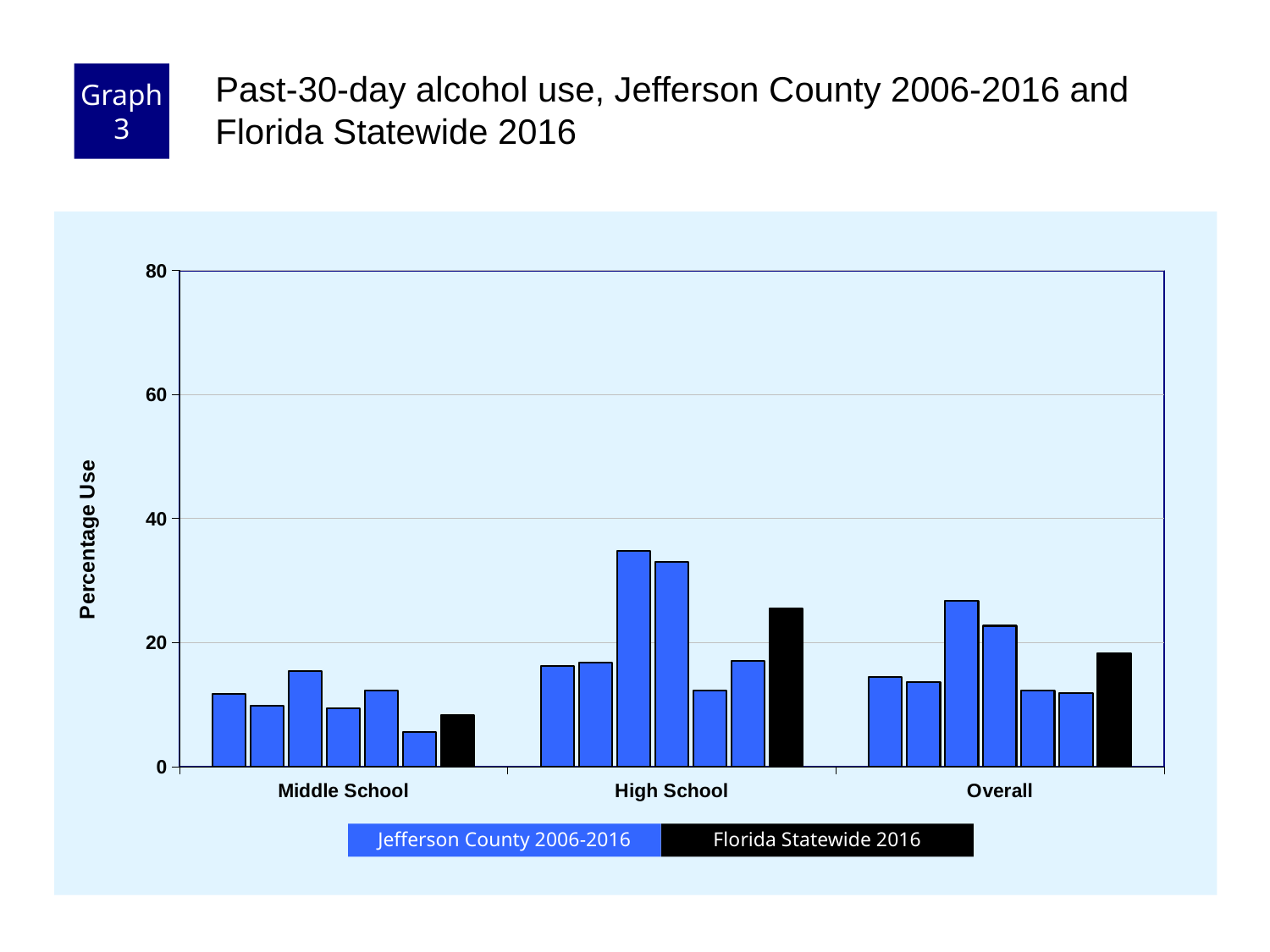
Which category has the tallest bar overall? High School Is the Florida Statewide 2016 value for Middle School greater or less than 20? less Is the Florida Statewide 2016 value for High School greater or less than 20? greater Which colour represents Florida Statewide 2016 in the legend? black How many categories are shown on the x axis? 3 Which is larger: the Florida Statewide 2016 bar for High School or the Florida Statewide 2016 bar for Middle School? High School Is the tallest Jefferson County 2006-2016 bar for High School greater or less than 40? less What is the label on the y axis? Percentage Use What kind of chart is shown on the slide? bar chart How many series does the legend list? 2 Which category has the lowest Florida Statewide 2016 bar? Middle School